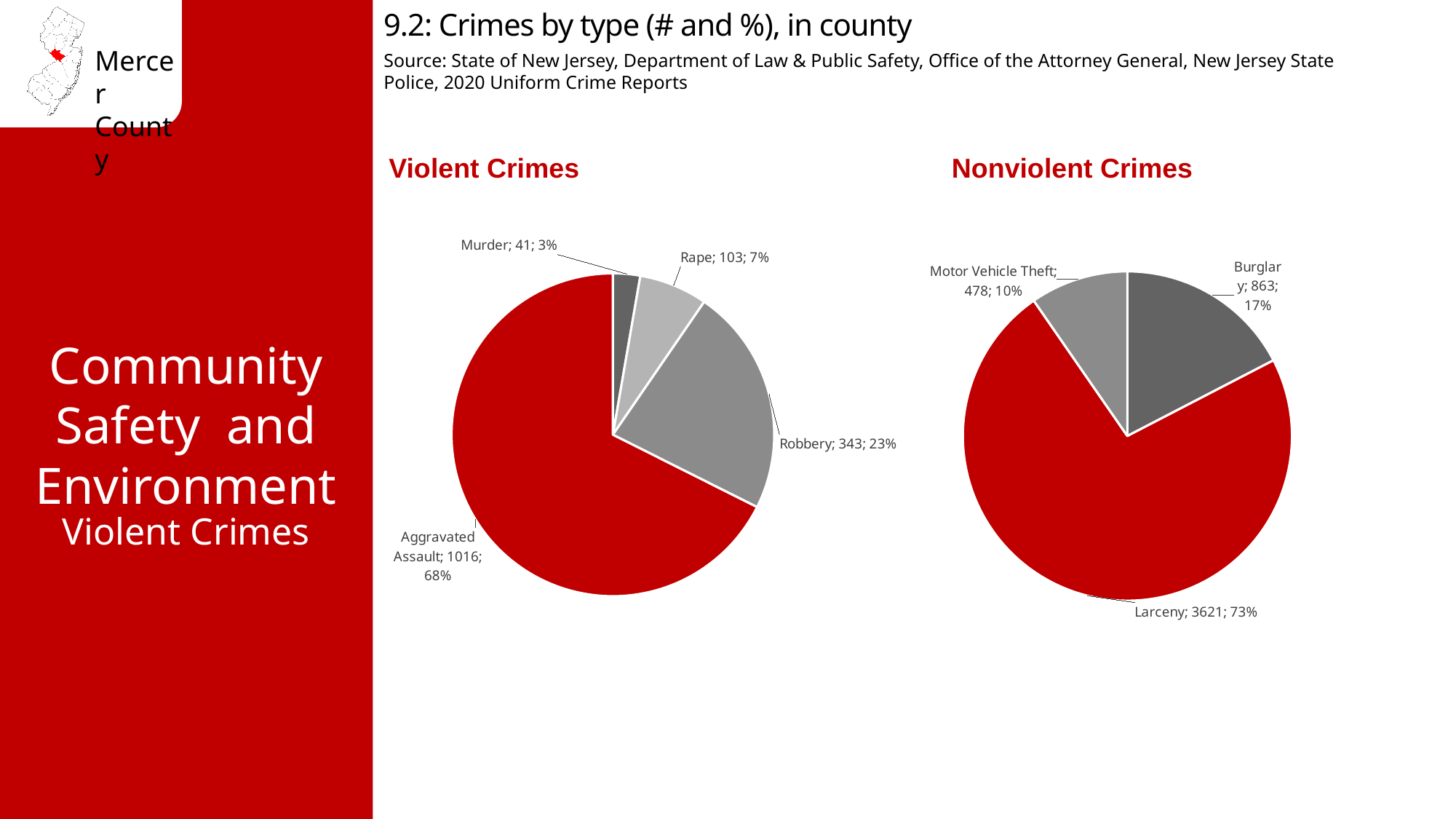
In the Nonviolent Crimes pie chart, what percentage share does Burglary have? 17% In the Nonviolent Crimes pie chart, what is the difference between the number of burglaries and the number of motor vehicle thefts? 385 In the Violent Crimes pie chart, how many aggravated assaults are shown? 1016 In the Nonviolent Crimes pie chart, how many larcenies are shown? 3621 In the Violent Crimes pie chart, what is the total number of crimes across all four categories? 1503 In the Violent Crimes pie chart, how many categories are shown? 4 In the Violent Crimes pie chart, what is the difference between the number of robberies and the number of rapes? 240 In the Violent Crimes pie chart, what percentage share does Robbery have? 23% In the Nonviolent Crimes pie chart, which category has the largest slice? Larceny In the Violent Crimes pie chart, which category has the smallest slice? Murder What type of chart is used for the Violent Crimes data? Pie chart In the Nonviolent Crimes pie chart, which is larger: Burglary or Motor Vehicle Theft? Burglary